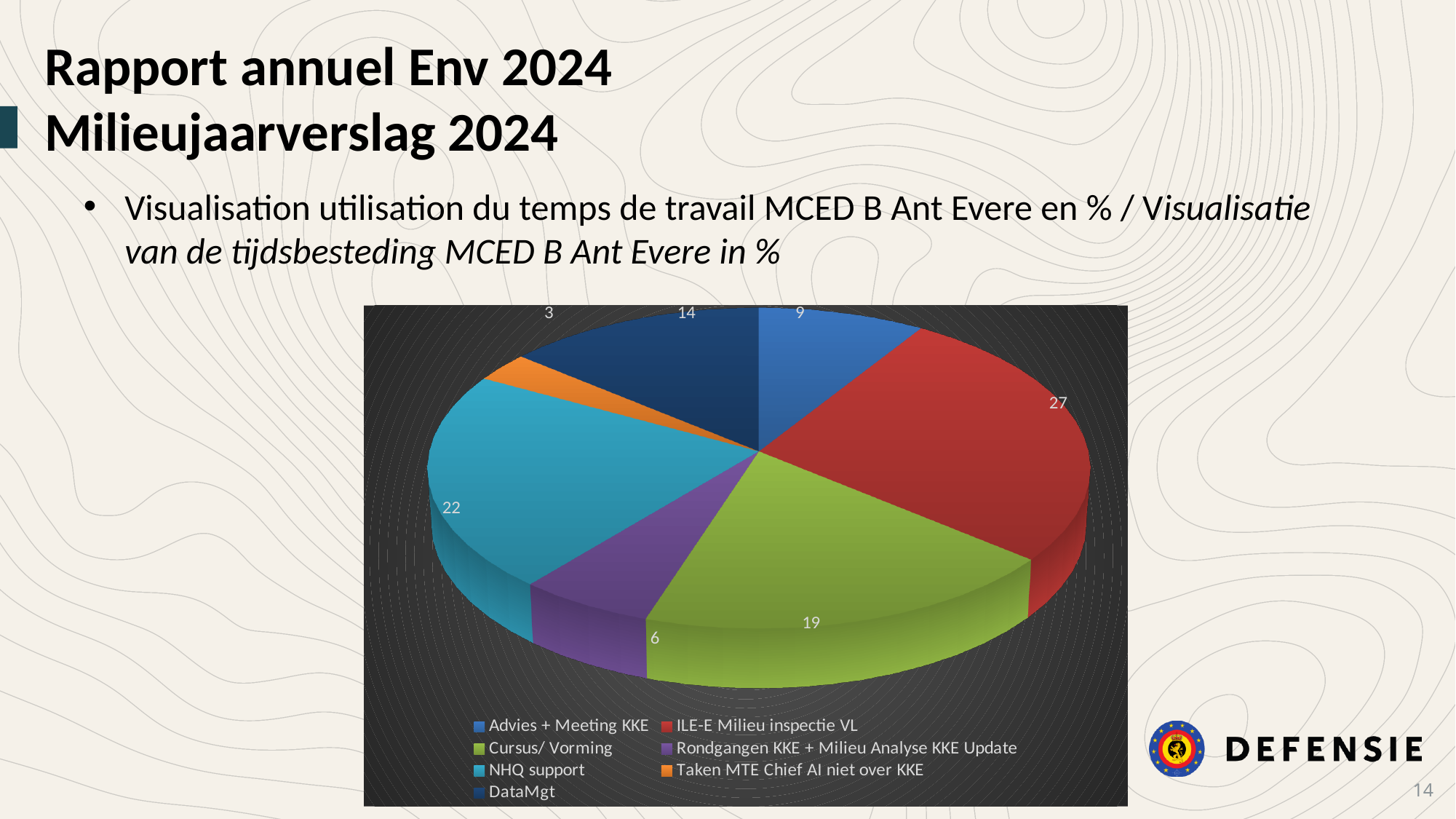
What is the value for ILE-E Milieu inspectie VL? 27 What is the value for Taken MTE Chief AI niet over KKE? 3 What is the value for DataMgt? 14 What is the value for NHQ support? 22 Which category has the largest slice of the pie? ILE-E Milieu inspectie VL What is the value for Cursus/ Vorming? 19 How many categories does the pie chart have? 7 What kind of chart is shown on the slide? pie chart Which is larger, the value for Advies + Meeting KKE or the value for Rondgangen KKE + Milieu Analyse KKE Update? Advies + Meeting KKE What is the difference between the values for ILE-E Milieu inspectie VL and NHQ support? 5 Which category has the smallest slice of the pie? Taken MTE Chief AI niet over KKE What colour is the slice for NHQ support? cyan